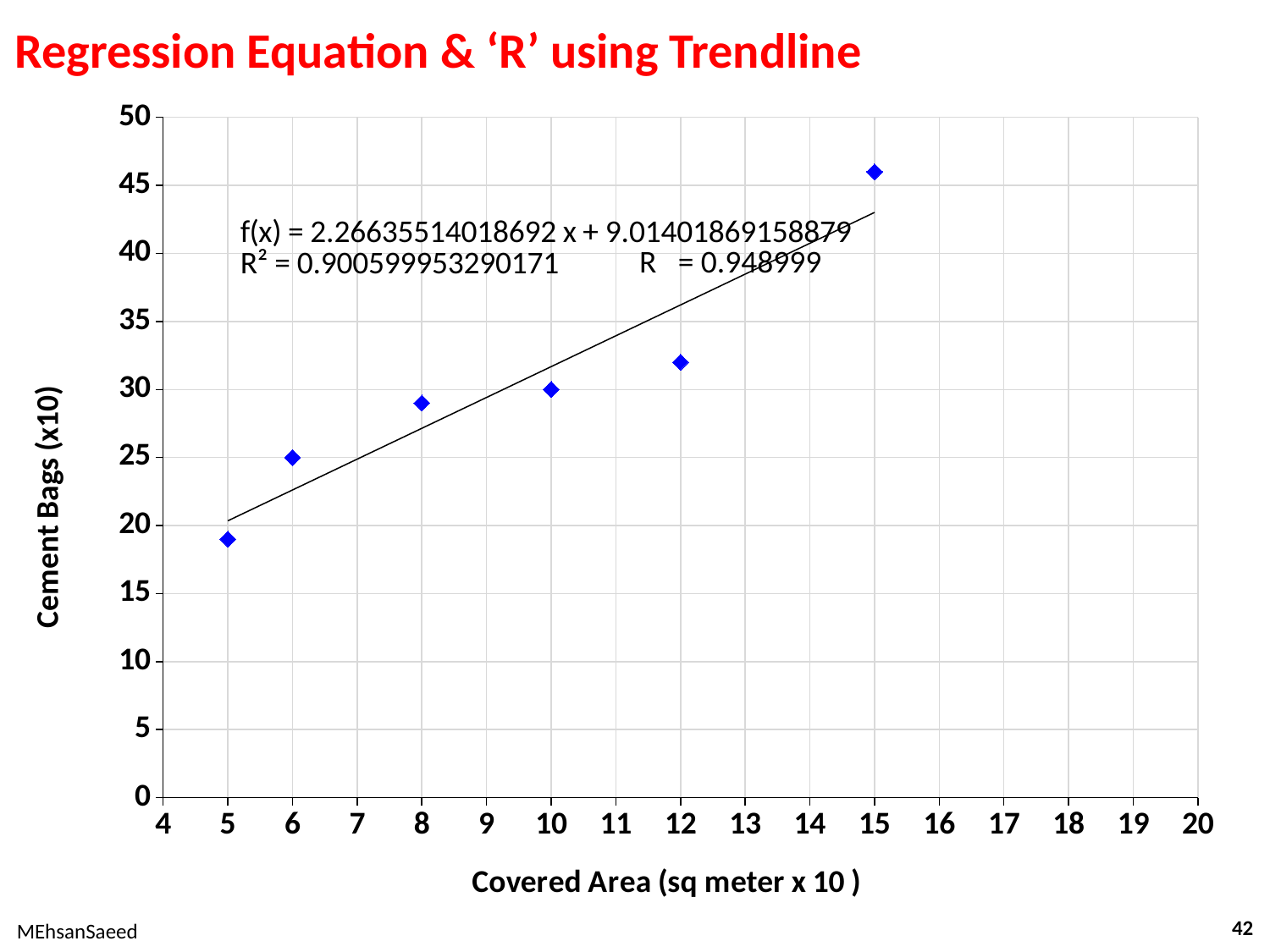
Is the Cement Bags value for a Covered Area of 12 greater or less than 30? greater What value of R is shown on the chart? 0.948999 Which has a higher Cement Bags value: Covered Area 8 or Covered Area 12? Covered Area 12 Is the Cement Bags value for a Covered Area of 15 greater or less than 45? greater What is the Cement Bags value for a Covered Area of 10? 30 At which Covered Area value is the Cement Bags value highest? 15 Is the Cement Bags value for a Covered Area of 5 greater or less than 20? less What is the Cement Bags value for a Covered Area of 6? 25 How many data points are plotted on the chart? 6 At which Covered Area value is the Cement Bags value lowest? 5 Do the Cement Bags values generally rise or fall as Covered Area increases? rise What kind of chart is shown on the slide? scatter chart